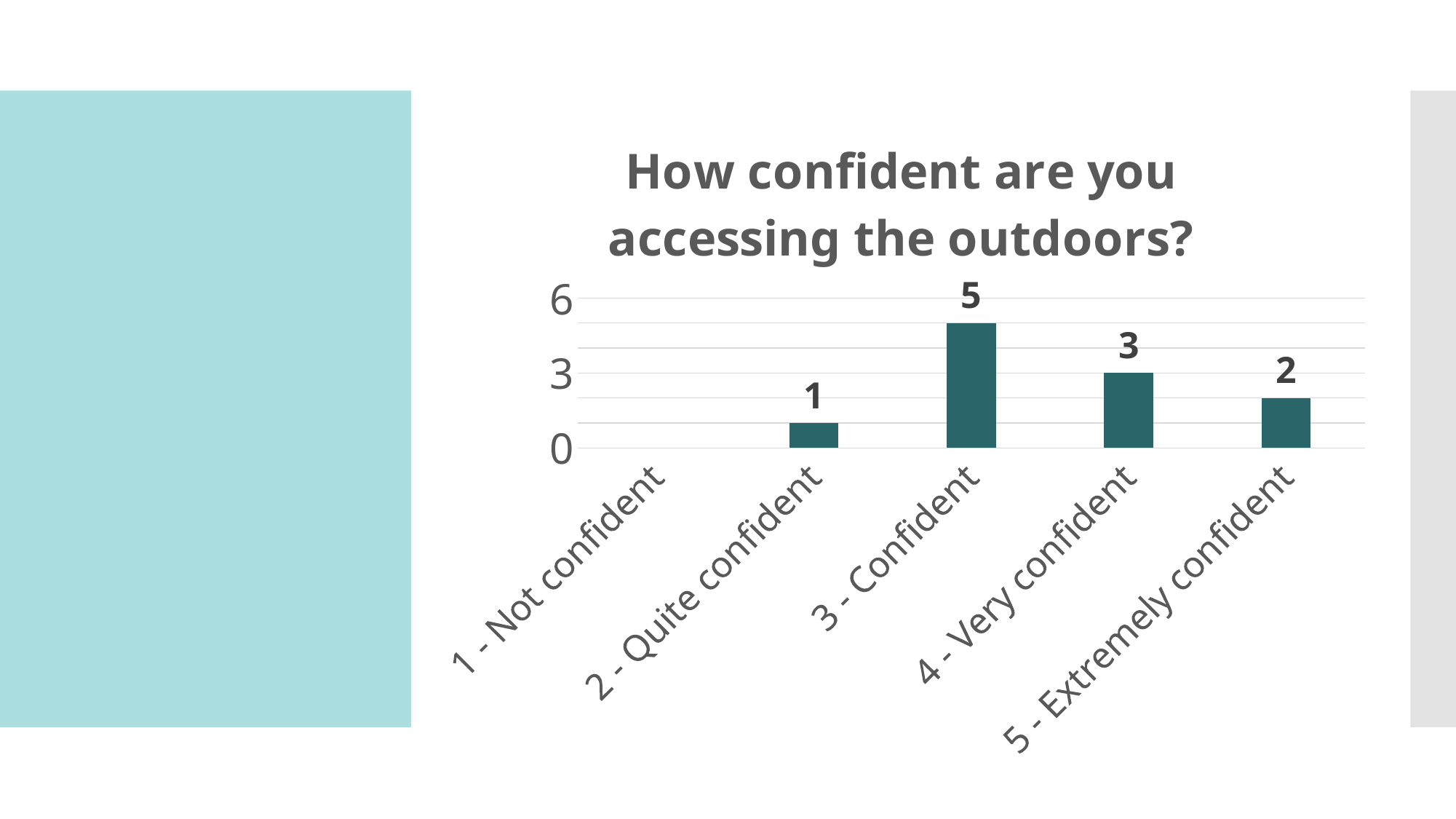
What is the title of the chart? How confident are you accessing the outdoors? What kind of chart is shown on the slide? bar chart What is the highest value shown on the y axis? 6 What is the value for "2 - Quite confident"? 1 What is the value for "3 - Confident"? 5 Is the value for "3 - Confident" greater or less than 3? greater Which category has the highest value? 3 - Confident How many categories are shown on the x axis? 5 What is the difference between the values for "3 - Confident" and "4 - Very confident"? 2 Which is larger, the value for "4 - Very confident" or the value for "5 - Extremely confident"? 4 - Very confident What is the value for "4 - Very confident"? 3 What is the value for "5 - Extremely confident"? 2